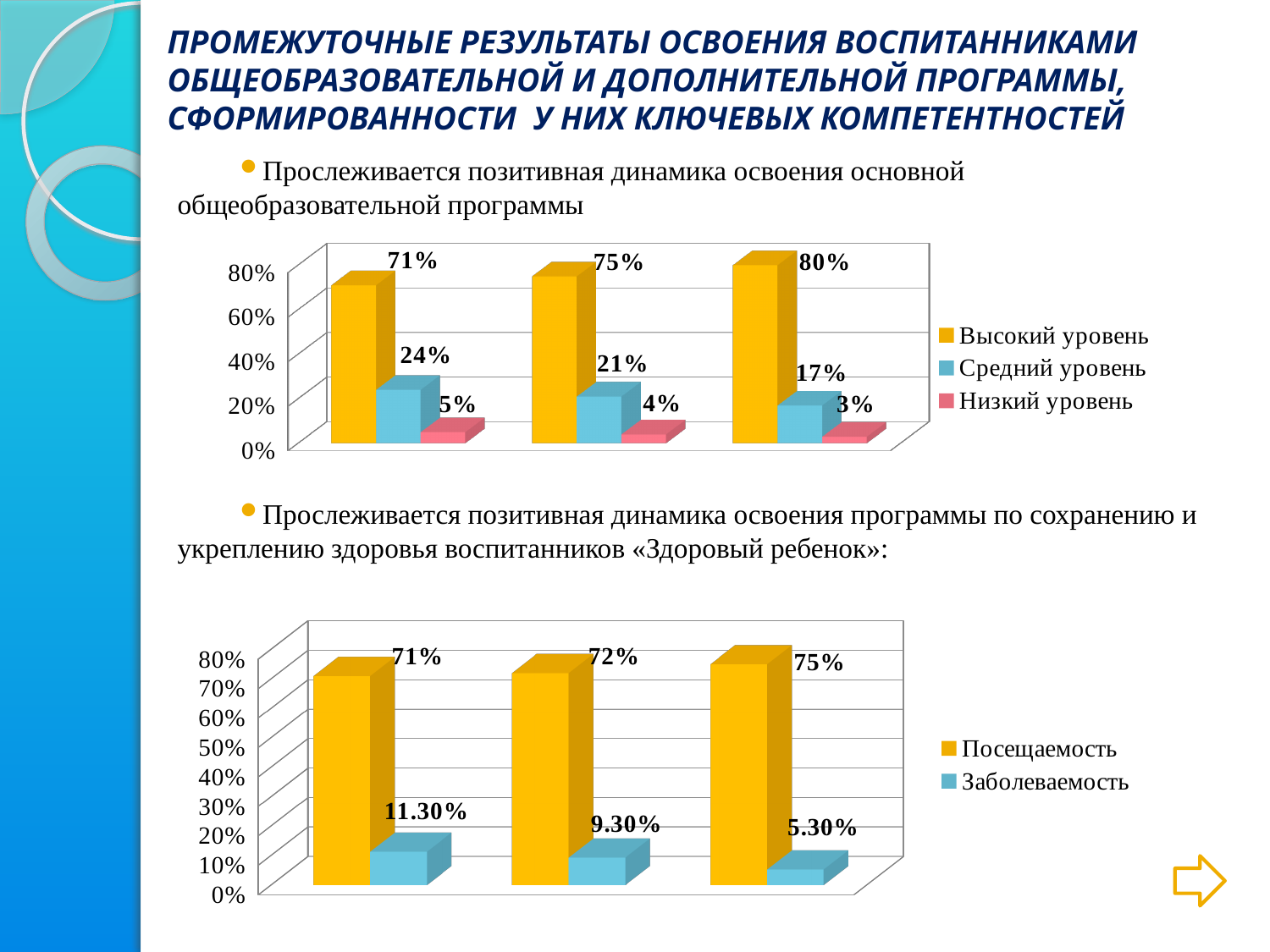
In the top chart, how many series does the legend list? 3 In the bottom chart, do the Заболеваемость values rise or fall from left to right? fall In the bottom chart, how many series does the legend list? 2 In the bottom chart, what is the value of Заболеваемость for the first (leftmost) group of bars? 11.30% In the top chart, what is the difference between the Высокий уровень values of the third and first groups of bars? 9% In the top chart, what is the value of Высокий уровень for the third (rightmost) group of bars? 80% In the top chart, what is the lowest value shown for Низкий уровень? 3% What kind of chart is the bottom chart? bar chart In the bottom chart, what is the highest value shown for Посещаемость? 75% In the top chart, which series is shown in yellow? Высокий уровень In the top chart, what is the value of Средний уровень for the first (leftmost) group of bars? 24% In the top chart, do the Высокий уровень values rise or fall from left to right? rise